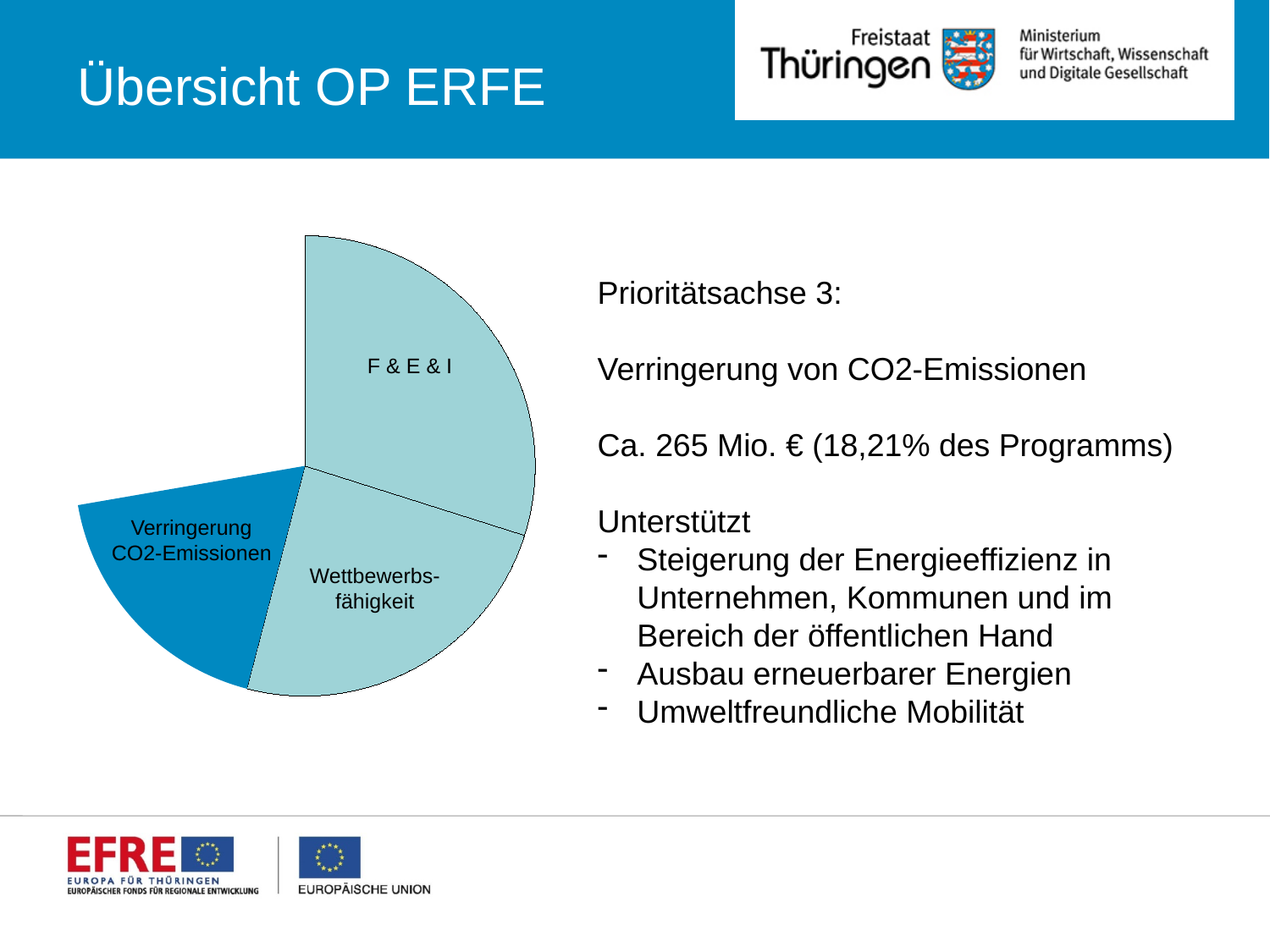
Which slice of the pie chart is the smallest? Verringerung CO2-Emissionen Which slice is larger, Wettbewerbsfähigkeit or Verringerung CO2-Emissionen? Wettbewerbsfähigkeit Which slice of the pie chart is pulled out (exploded) from the rest? Verringerung CO2-Emissionen Which slice of the pie chart is the largest? F & E & I How many slices does the pie chart have? 3 Which slice is larger, F & E & I or Verringerung CO2-Emissionen? F & E & I What kind of chart is shown on the slide? pie chart Which slice is larger, F & E & I or Wettbewerbsfähigkeit? F & E & I What colour is the Verringerung CO2-Emissionen slice? dark blue According to the slide text, what share of the programme does the Verringerung CO2-Emissionen slice represent? 18,21%